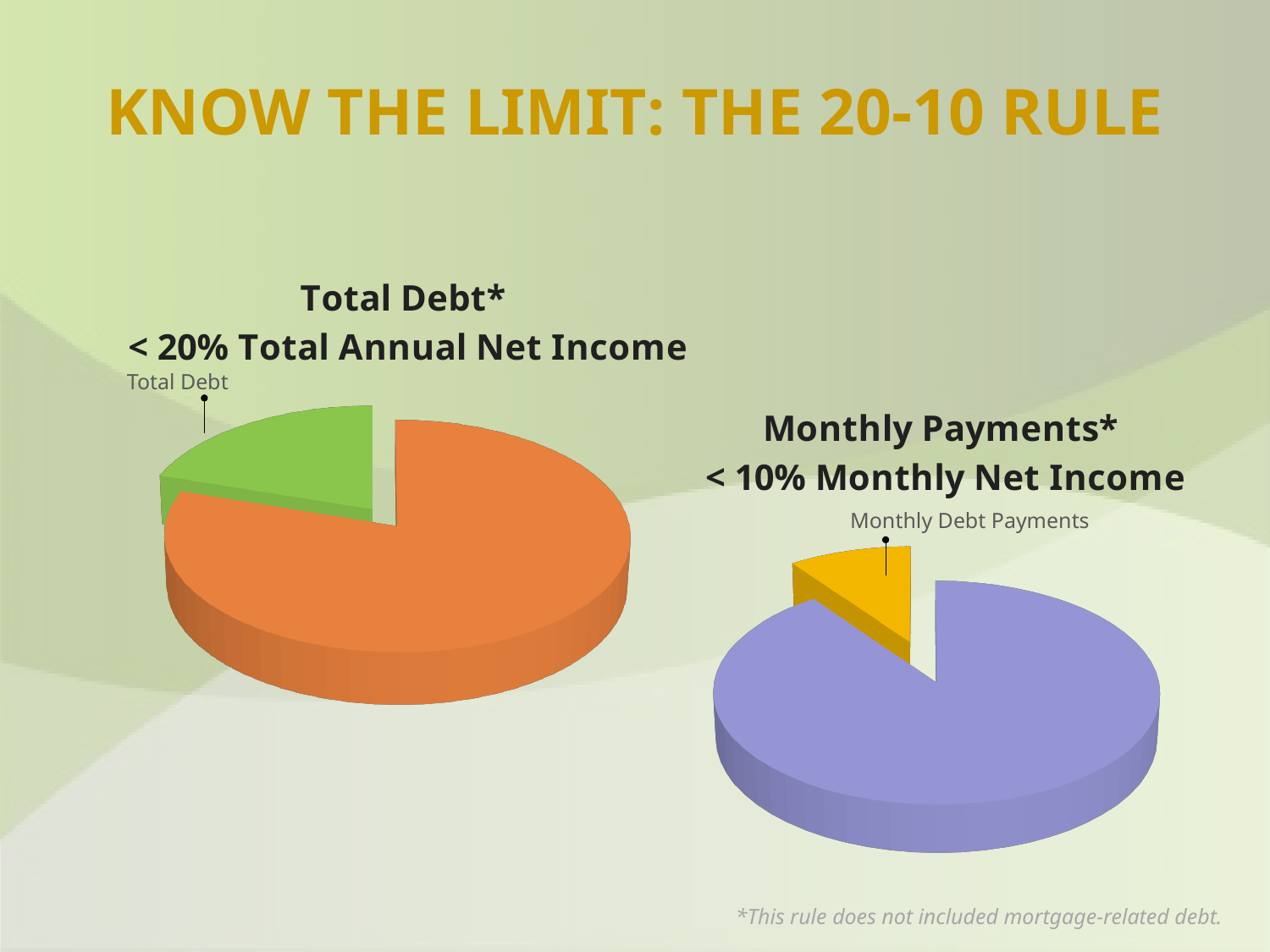
In the left pie chart (Total Debt*), which slice is the smallest? Total Debt In the right pie chart (Monthly Payments*), which slice is the smallest? Monthly Debt Payments In the right pie chart (Monthly Payments*), is the slice labelled "Monthly Debt Payments" larger or smaller than the other slice? Smaller What is the label of the green slice in the left pie chart? Total Debt What kind of chart is the right chart titled "Monthly Payments*"? Pie chart What is the label of the yellow slice in the right pie chart? Monthly Debt Payments How many pie charts are shown on the slide? 2 What kind of chart is the left chart titled "Total Debt*"? Pie chart In the left pie chart (Total Debt*), is the slice labelled "Total Debt" larger or smaller than the other slice? Smaller How many slices does the left pie chart (Total Debt*) have? 2 How many slices does the right pie chart (Monthly Payments*) have? 2